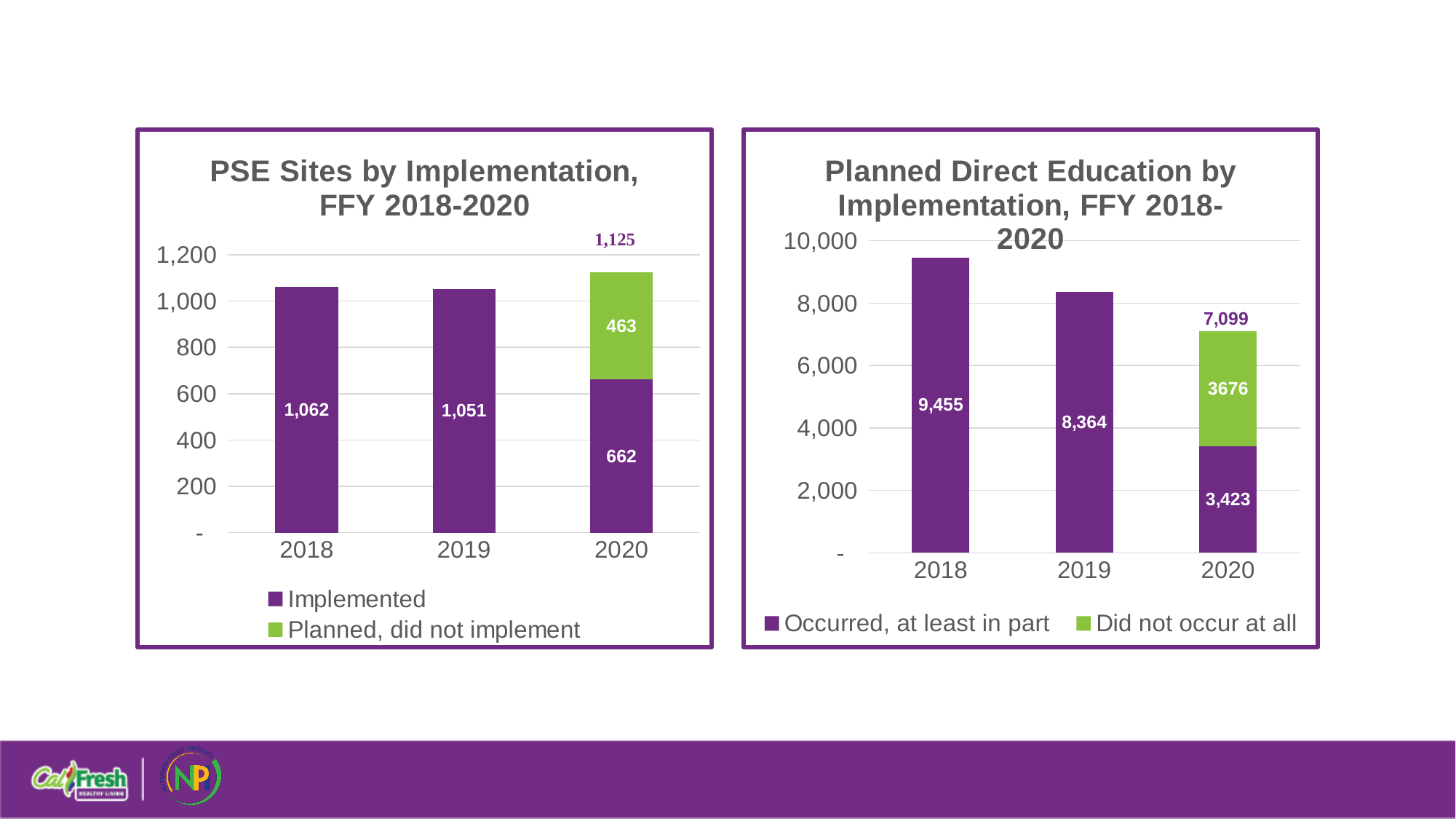
In the 'PSE Sites by Implementation, FFY 2018-2020' chart, which year has the lowest Implemented value? 2020 In the 'PSE Sites by Implementation, FFY 2018-2020' chart, what is the total of the stacked bar for 2020? 1,125 In the 'Planned Direct Education by Implementation, FFY 2018-2020' chart, what is the 'Did not occur at all' value for 2020? 3676 In the 'Planned Direct Education by Implementation, FFY 2018-2020' chart, what is the 'Occurred, at least in part' value for 2019? 8,364 In the 'PSE Sites by Implementation, FFY 2018-2020' chart, what is the 'Planned, did not implement' value for 2020? 463 In the 'PSE Sites by Implementation, FFY 2018-2020' chart, what is the Implemented value for 2018? 1,062 In the 'Planned Direct Education by Implementation, FFY 2018-2020' chart, what is the difference between the 'Occurred, at least in part' values for 2018 and 2019? 1,091 What kind of chart is the 'Planned Direct Education by Implementation, FFY 2018-2020' chart? Stacked bar chart In the 'Planned Direct Education by Implementation, FFY 2018-2020' chart, how many years are shown on the x axis? 3 In the 'Planned Direct Education by Implementation, FFY 2018-2020' chart, which year has the highest 'Occurred, at least in part' value? 2018 In the 'PSE Sites by Implementation, FFY 2018-2020' chart, how many series does the legend list? 2 In the 'PSE Sites by Implementation, FFY 2018-2020' chart, what is the difference between the Implemented values for 2018 and 2019? 11